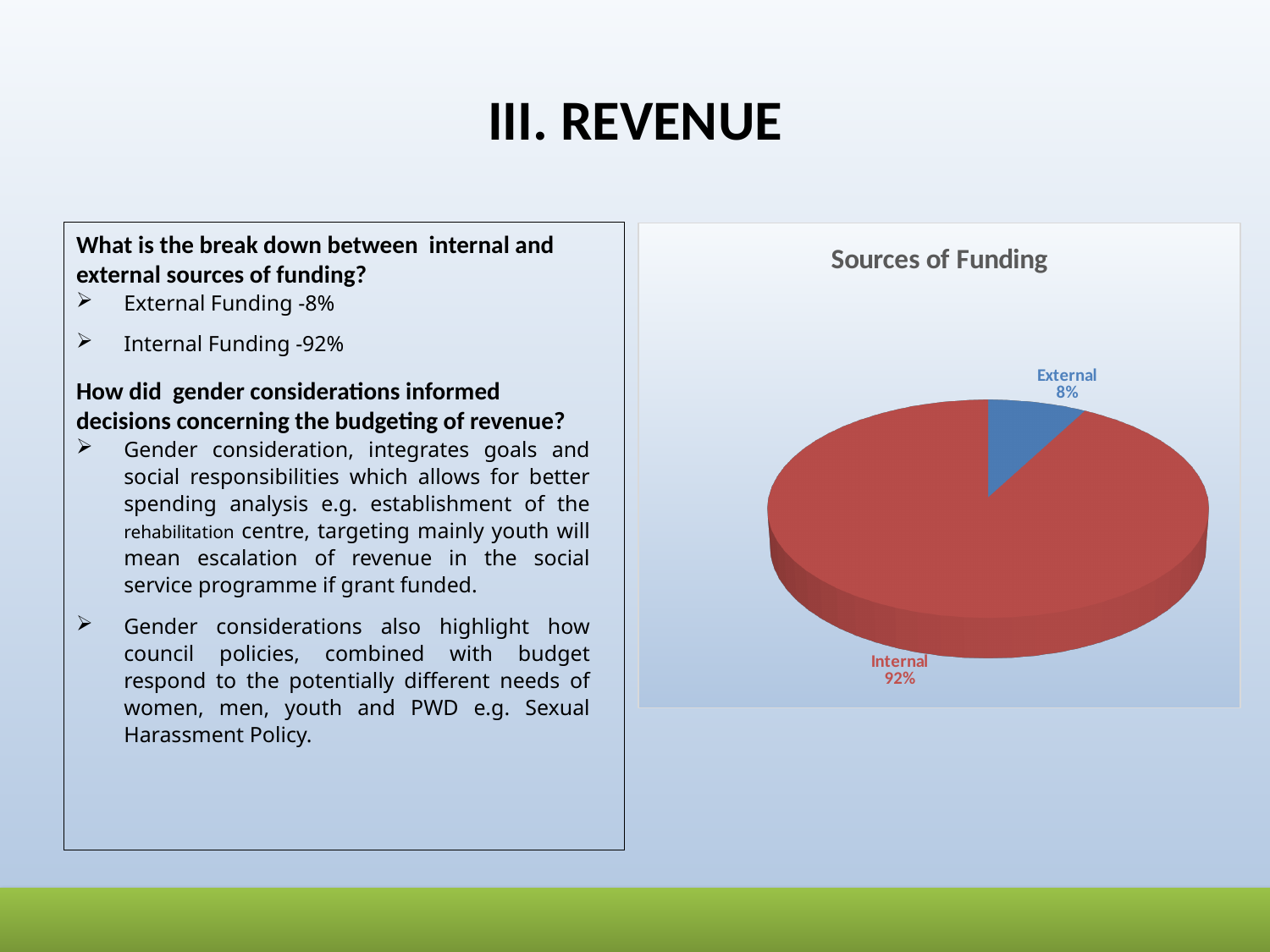
What share of the pie does External funding represent? 8% How many slices does the pie chart have? 2 What share of the pie does Internal funding represent? 92% What is the difference in percentage points between the Internal and External slices? 84 What colour is the Internal slice of the pie? red Which slice of the pie is the largest? Internal What is the title of the chart? Sources of Funding Which is larger, the Internal slice or the External slice? Internal Which slice of the pie is the smallest? External What kind of chart is shown on the slide? pie chart